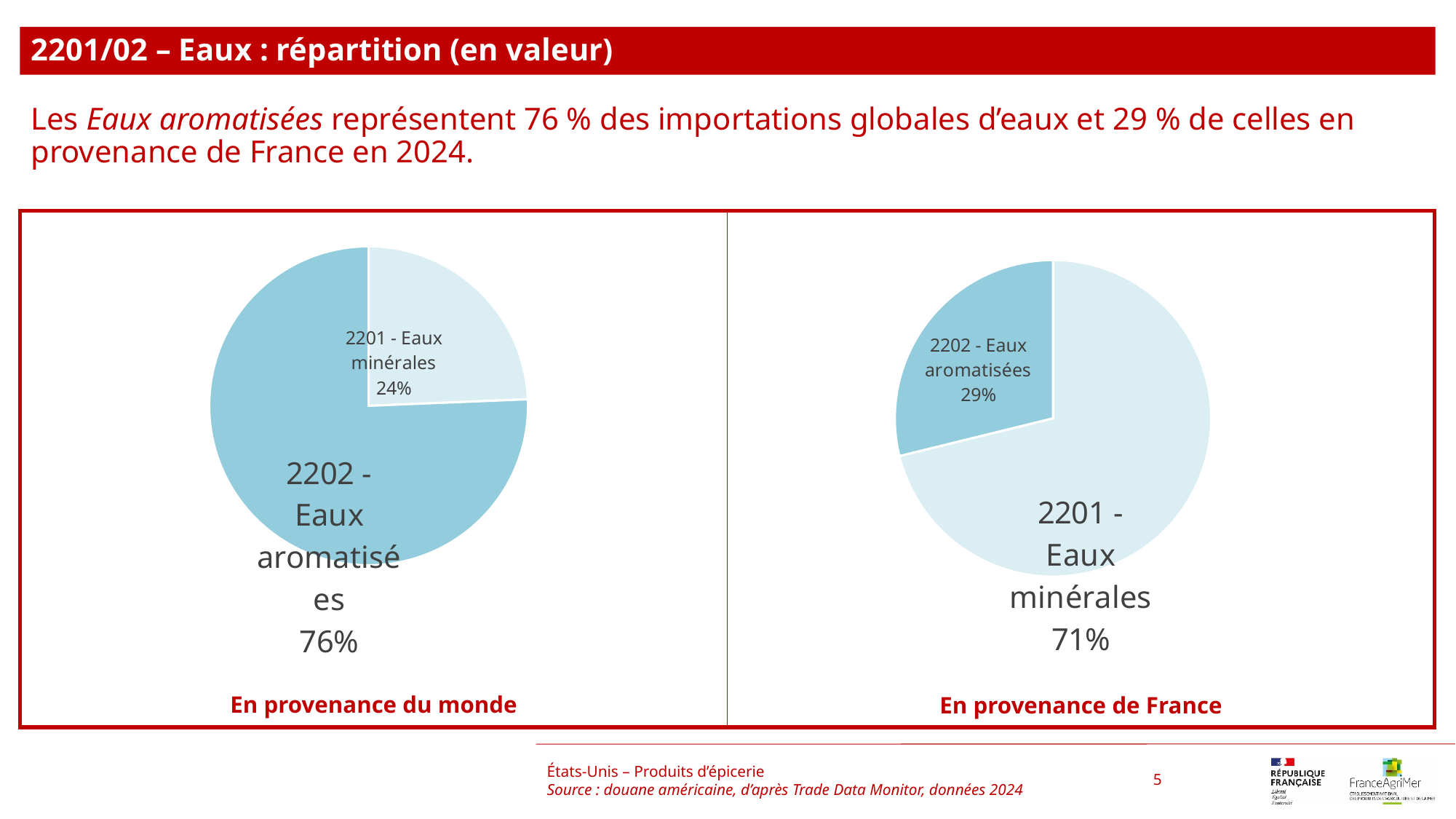
In the 'En provenance du monde' pie chart, what share does '2201 - Eaux minérales' have? 24% In the 'En provenance du monde' pie chart, what share does '2202 - Eaux aromatisées' have? 76% In the 'En provenance de France' pie chart, what share does '2201 - Eaux minérales' have? 71% In the 'En provenance du monde' pie chart, what is the difference in percentage points between the two slices? 52 In the 'En provenance de France' pie chart, what is the difference in percentage points between the two slices? 42 What is the title of the chart on the right side of the slide? En provenance de France What type of chart is used for 'En provenance du monde'? Pie chart How many slices does the 'En provenance de France' pie chart have? 2 In the 'En provenance de France' pie chart, which category has the smallest share? 2202 - Eaux aromatisées Which is larger: the share of '2202 - Eaux aromatisées' in the 'En provenance du monde' chart or in the 'En provenance de France' chart? En provenance du monde In the 'En provenance du monde' pie chart, which category has the largest share? 2202 - Eaux aromatisées